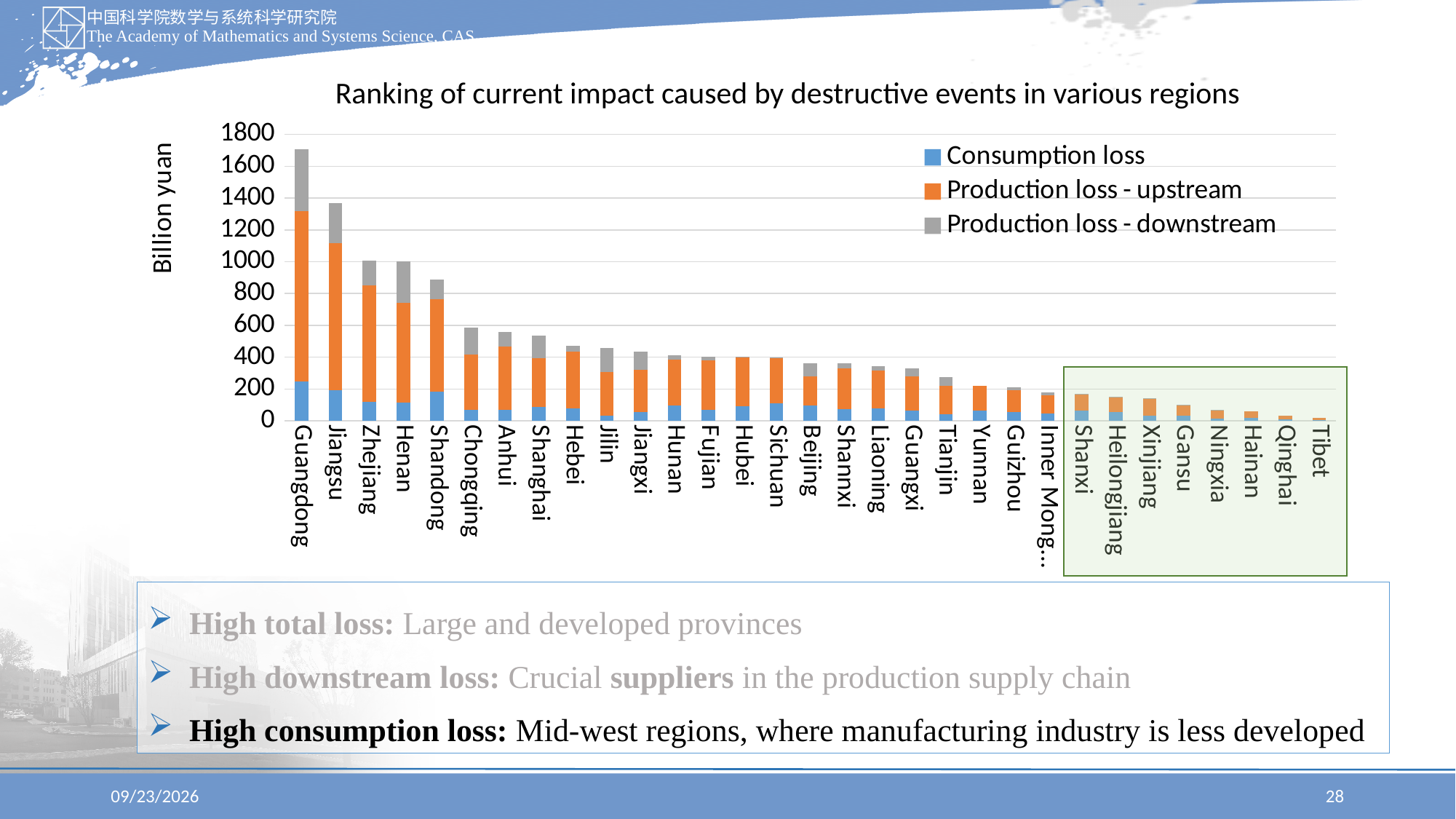
Is the total loss for Guangdong greater or less than 1600 billion yuan? greater Is the total loss for Yunnan greater or less than 400 billion yuan? less How many regions are plotted along the x axis? 31 Is the total loss for Shandong greater or less than 800 billion yuan? greater Which region has the highest total loss? Guangdong What is the label on the vertical axis of the chart? Billion yuan How many series does the legend list? 3 Which region has the lowest total loss? Tibet What kind of chart is shown on the slide? stacked bar chart Do the total losses rise or fall moving from left to right along the x axis? fall Which region has a larger total loss, Shandong or Chongqing? Shandong